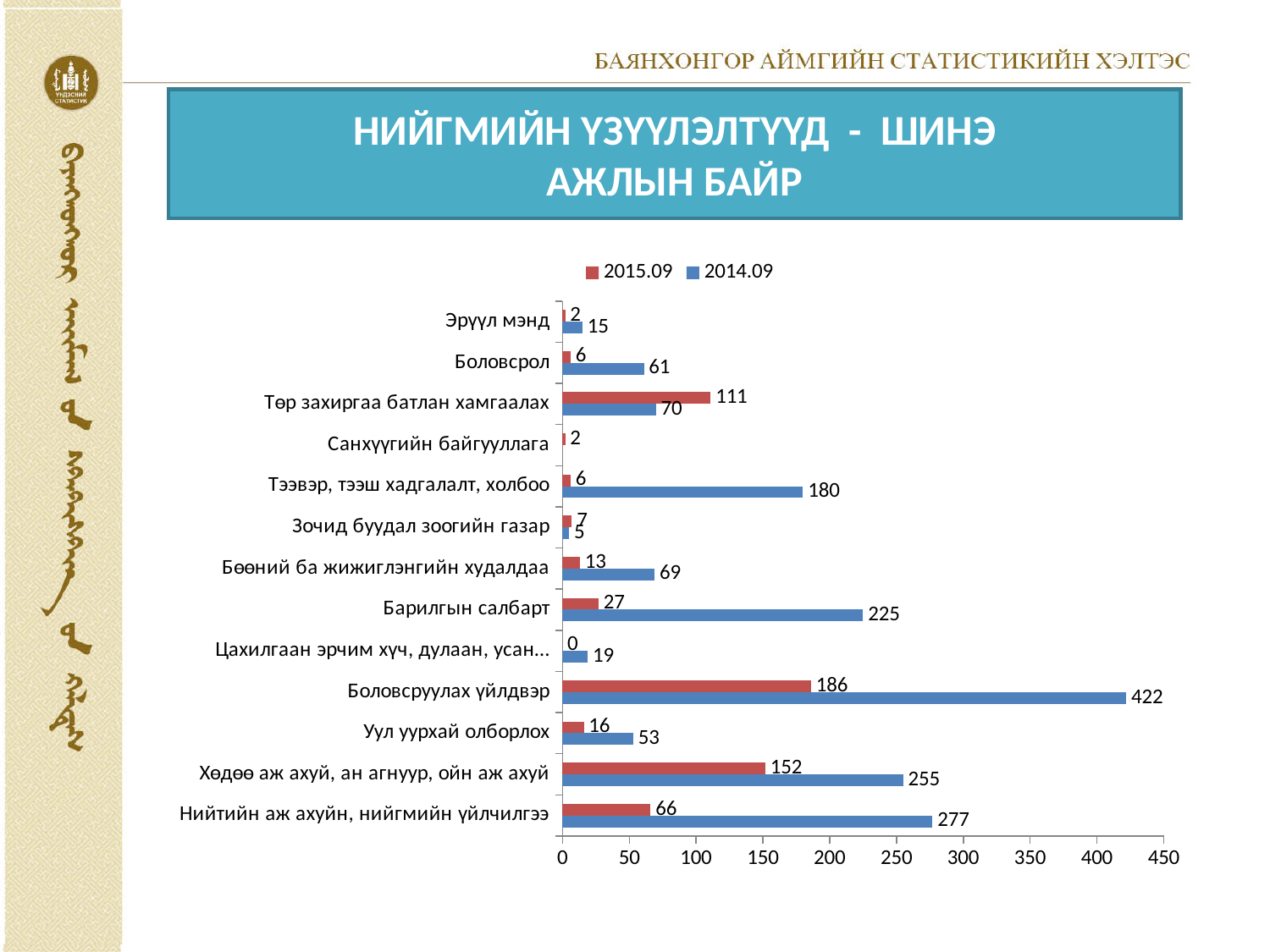
What is the 2014.09 value for Боловсруулах үйлдвэр? 422 Which category has the lowest 2015.09 value? Цахилгаан эрчим хүч, дулаан, усан... What is the 2014.09 value for Тээвэр, тээш хадгалалт, холбоо? 180 How many series does the legend list? 2 Which colour represents the 2015.09 series? Red For Төр захиргаа батлан хамгаалах, which series has the larger value, 2015.09 or 2014.09? 2015.09 What is the difference between the 2014.09 and 2015.09 values for Барилгын салбарт? 198 How many categories are shown on the chart? 13 What is the 2015.09 value for Хөдөө аж ахуй, ан агнуур, ойн аж ахуй? 152 What kind of chart is shown on the slide? Bar chart Which category has the highest 2014.09 value? Боловсруулах үйлдвэр Is the 2014.09 value for Нийтийн аж ахуйн, нийгмийн үйлчилгээ greater or less than 250? greater